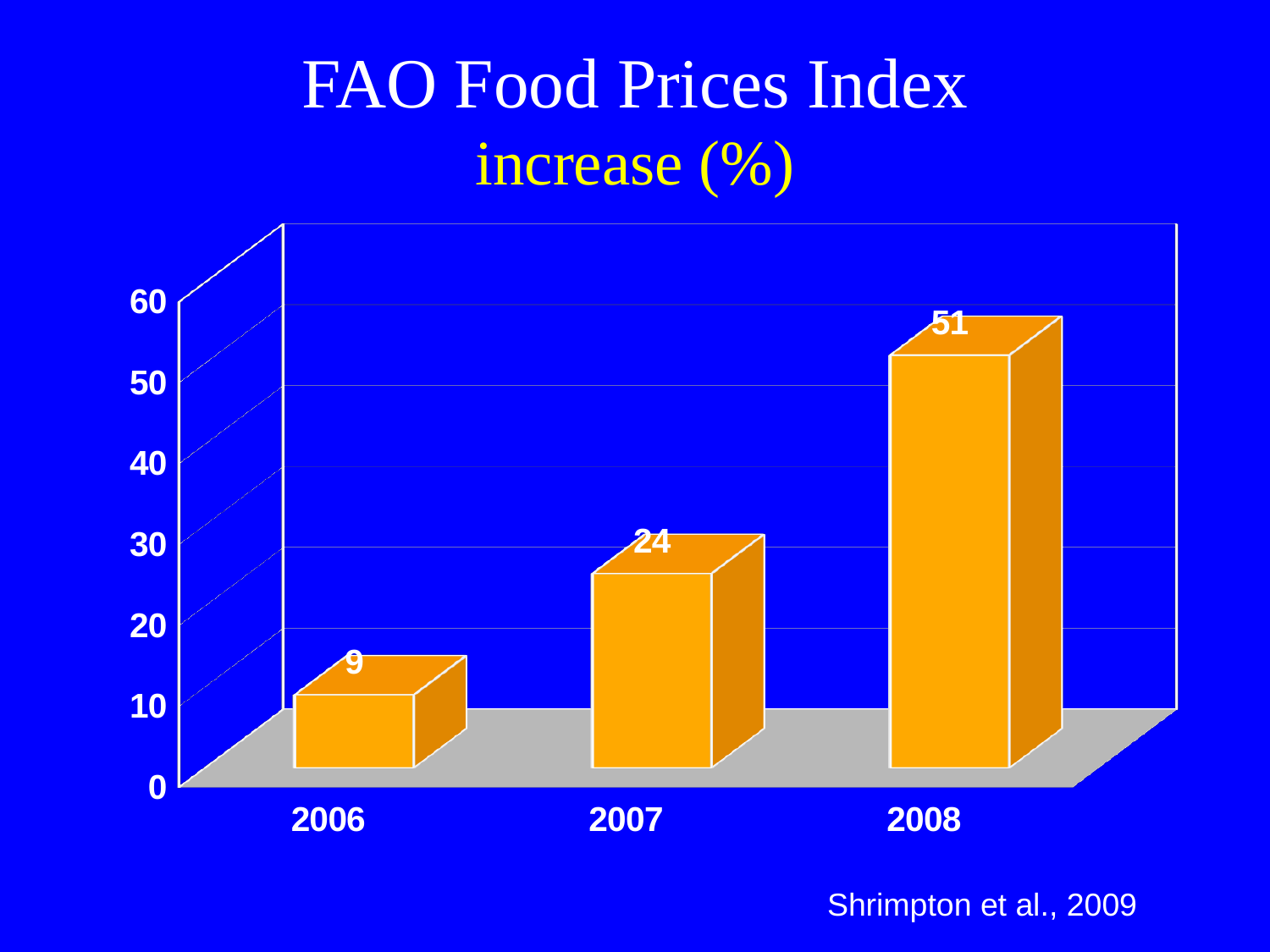
What is the value for 2006? 9 How many years are shown on the x axis? 3 Do the values rise or fall from 2006 to 2008? rise What is the value for 2008? 51 Is the value for 2008 greater or less than 40? greater What is the difference between the values for 2007 and 2006? 15 What is the difference between the values for 2008 and 2007? 27 Which is larger, the value for 2007 or the value for 2006? 2007 Which year has the highest value? 2008 Which year has the lowest value? 2006 What kind of chart is shown on the slide? bar chart What is the value for 2007? 24